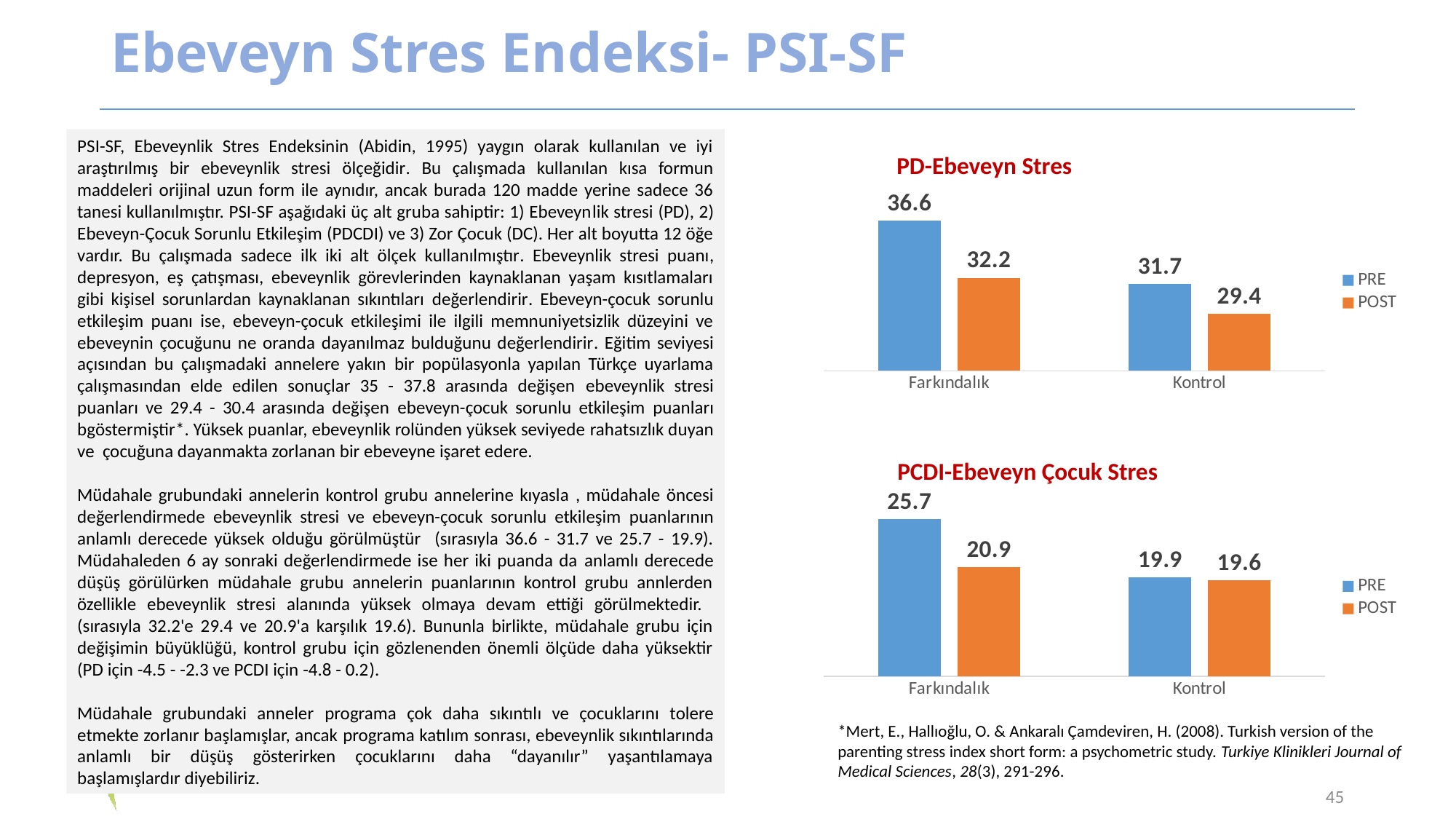
How many series does the legend of the PCDI-Ebeveyn Çocuk Stres chart list? 2 In the PD-Ebeveyn Stres chart, what is the POST value for Kontrol? 29.4 In the PD-Ebeveyn Stres chart, which bar has the highest value? Farkındalık PRE In the PCDI-Ebeveyn Çocuk Stres chart, which bar has the lowest value? Kontrol POST What type of chart is the PD-Ebeveyn Stres chart? Bar chart How many categories are shown on the x axis of the PD-Ebeveyn Stres chart? 2 In the PD-Ebeveyn Stres chart, what is the difference between the PRE and POST values for Farkındalık? 4.4 In the PCDI-Ebeveyn Çocuk Stres chart, what is the PRE value for Kontrol? 19.9 In the PCDI-Ebeveyn Çocuk Stres chart, what is the POST value for Farkındalık? 20.9 In the PD-Ebeveyn Stres chart, which is larger: the POST value for Farkındalık or the PRE value for Kontrol? POST value for Farkındalık In the PCDI-Ebeveyn Çocuk Stres chart, what is the difference between the PRE and POST values for Farkındalık? 4.8 In the PD-Ebeveyn Stres chart, what is the PRE value for Farkındalık? 36.6